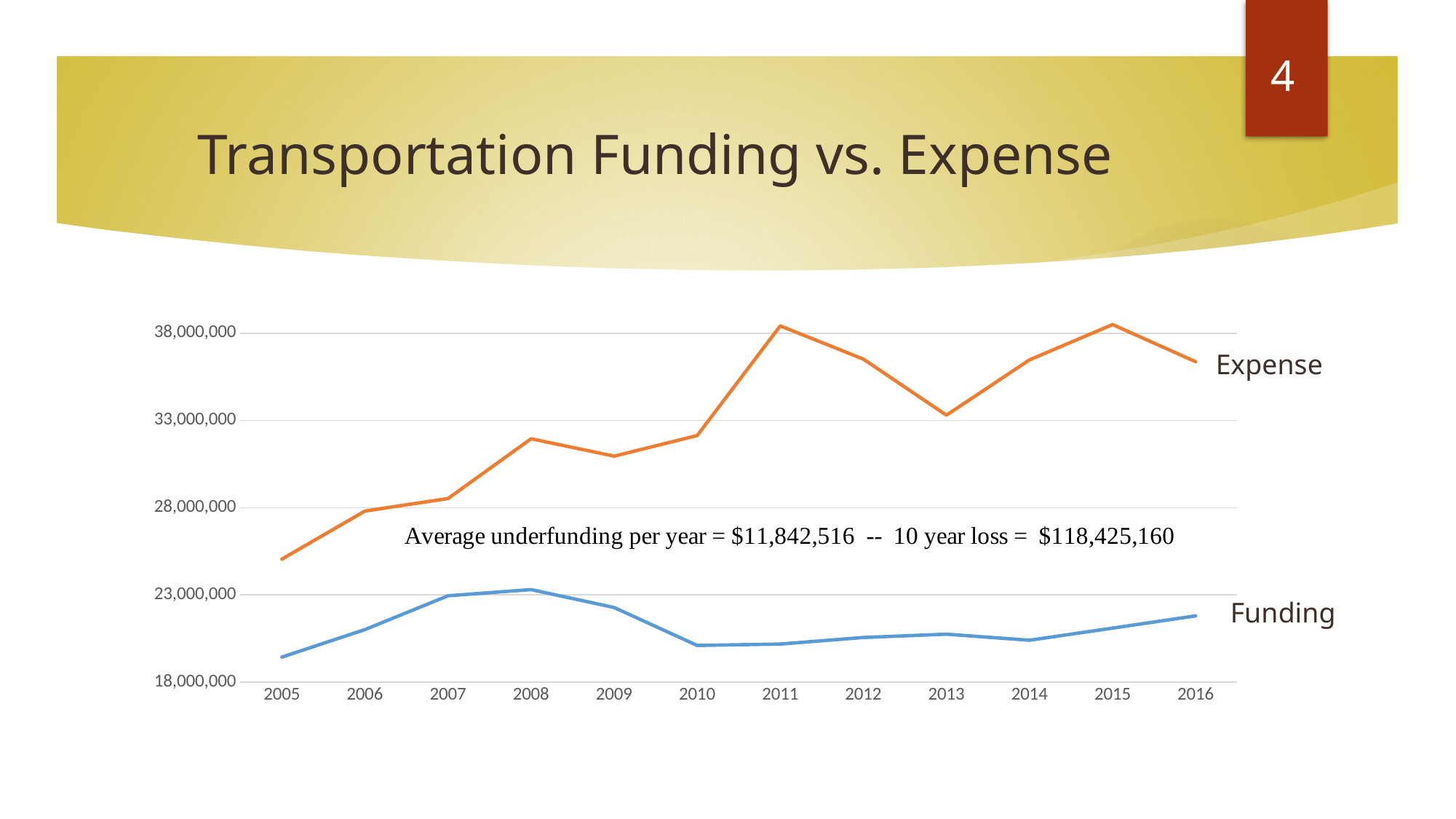
Is the Expense value for 2011 greater or less than 38,000,000? greater In which year is the Expense value lowest? 2005 What kind of chart is shown on the slide? line chart Is the Expense value for 2005 greater or less than 28,000,000? less How many years are shown along the x axis of the chart? 12 In 2010, which is larger, Expense or Funding? Expense Does the Expense line rise or fall from 2005 to 2008? rise How many series are plotted on the chart? 2 In which year is the Funding value lowest? 2005 What is the title of the slide containing the chart? Transportation Funding vs. Expense Is the Funding value for 2010 greater or less than 23,000,000? less